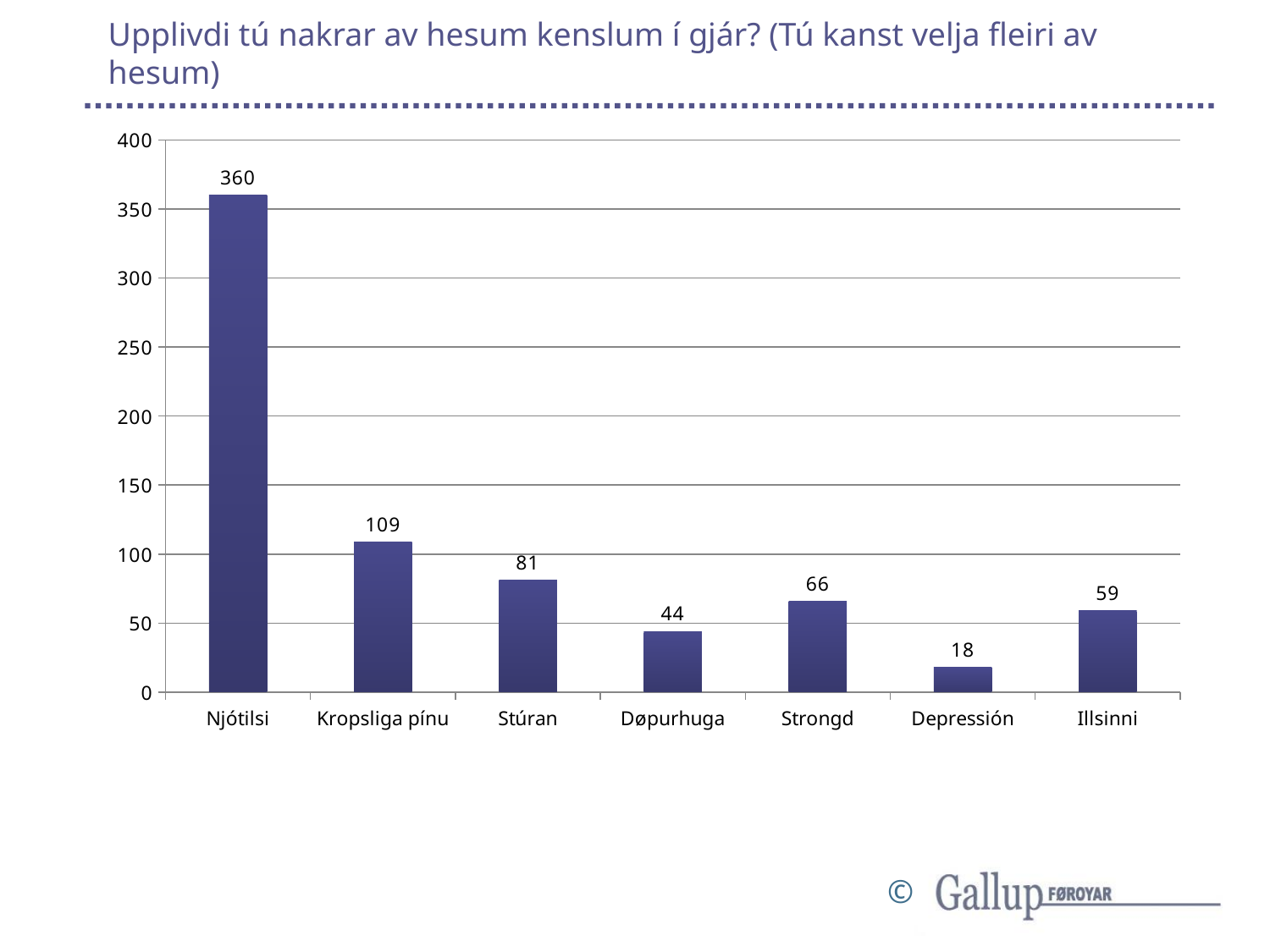
Is the value for Kropsliga pínu greater or less than 100? greater How many categories are shown on the x axis? 7 What is the value for Njótilsi? 360 Which category has the lowest value? Depressión What is the value for Kropsliga pínu? 109 What is the value for Depressión? 18 What is the difference between the values for Njótilsi and Kropsliga pínu? 251 What is the difference between the values for Stúran and Døpurhuga? 37 Which category has the highest value? Njótilsi Which is larger, the value for Strongd or the value for Illsinni? Strongd What kind of chart is shown on the slide? Bar chart What is the value for Illsinni? 59